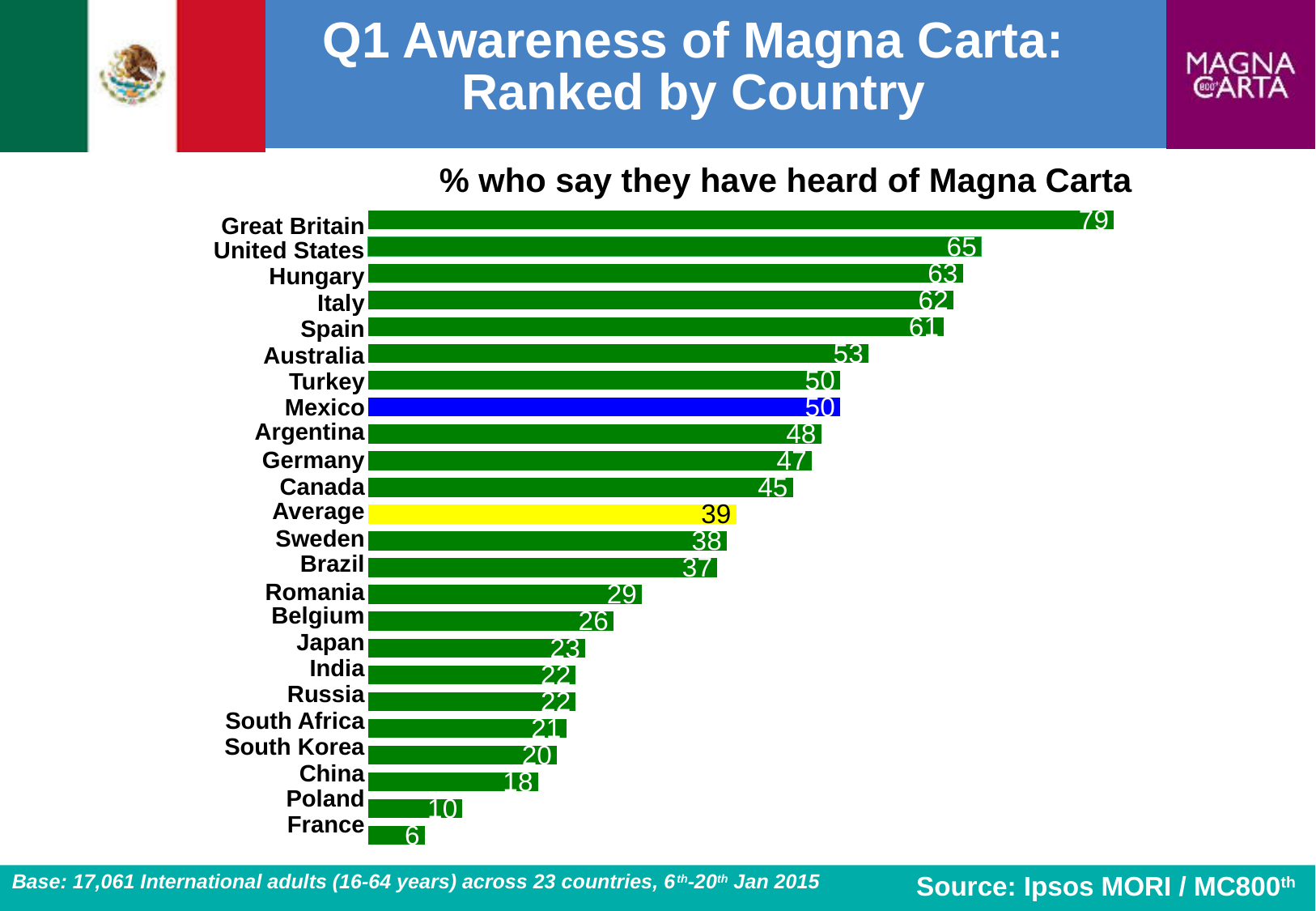
How many bars are plotted on the chart, including the Average bar? 24 Which has a higher value, Japan or Romania? Romania Which country has the lowest percentage who say they have heard of Magna Carta? France Which bar on the chart is coloured blue? Mexico What percentage of people in Great Britain say they have heard of Magna Carta? 79 What is the difference between the values for Mexico and the Average? 11 Which has a higher value, Canada or Sweden? Canada What is the value shown for Mexico? 50 What is the Average value shown on the chart? 39 What is the difference between the values for Great Britain and the United States? 14 Which country has the highest percentage who say they have heard of Magna Carta? Great Britain What type of chart is shown on the slide? Bar chart